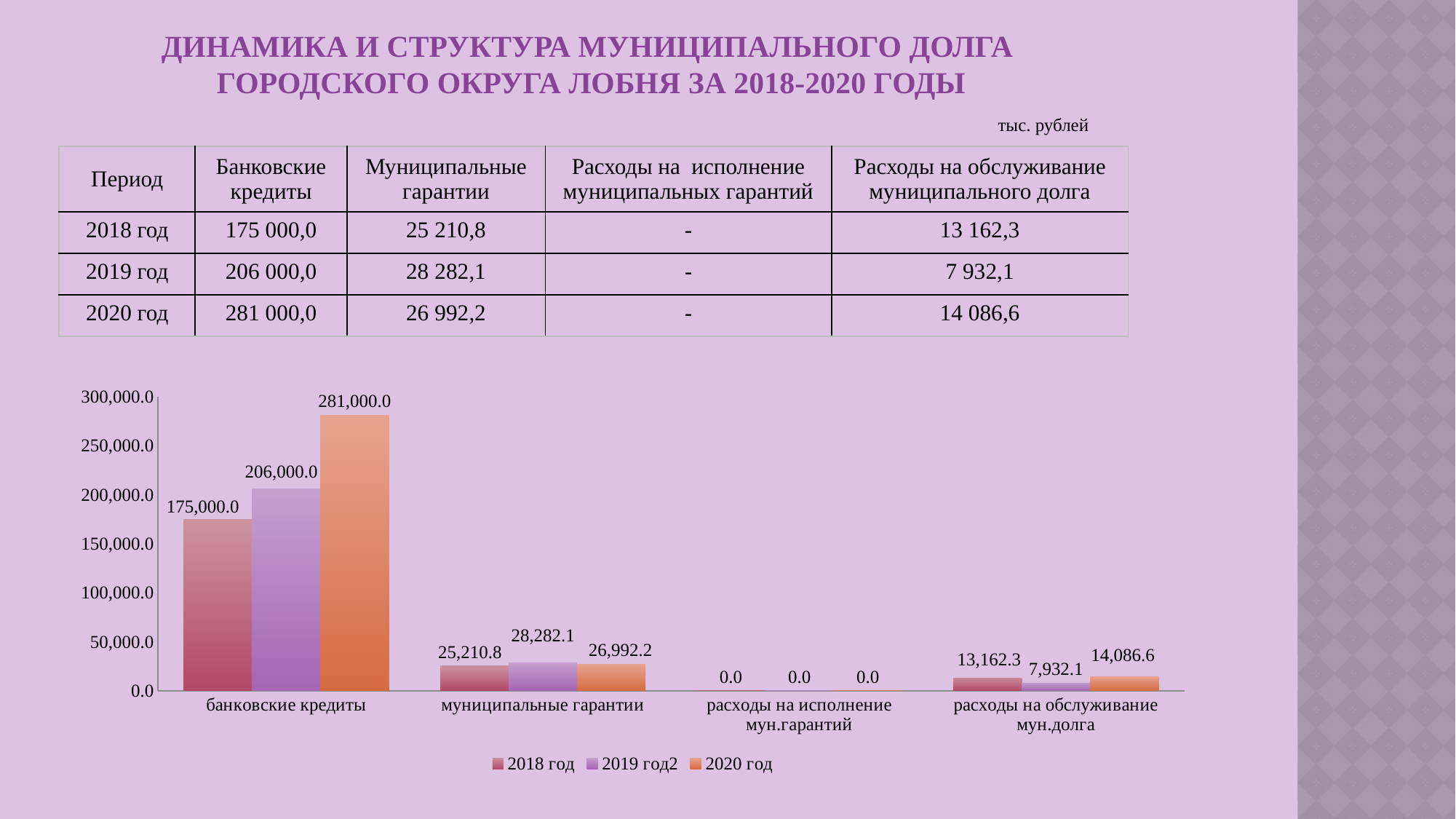
What is the value for банковские кредиты in the 2020 год series? 281,000.0 What is the value for расходы на исполнение мун.гарантий in the 2020 год series? 0.0 Which is larger for муниципальные гарантии: the 2019 год2 value or the 2020 год value? 2019 год2 What is the difference between the 2020 год and 2019 год2 values for расходы на обслуживание мун.долга? 6,154.5 Which category has the highest value in the 2019 год2 series? банковские кредиты Which year series has the lowest value for расходы на обслуживание мун.долга? 2019 год2 What is the value for муниципальные гарантии in the 2019 год2 series? 28,282.1 What is the difference between the 2020 год and 2018 год values for банковские кредиты? 106,000.0 What is the value for расходы на обслуживание мун.долга in the 2018 год series? 13,162.3 What kind of chart is shown on the slide? bar chart How many series does the chart legend list? 3 How many categories are shown on the x axis of the chart? 4